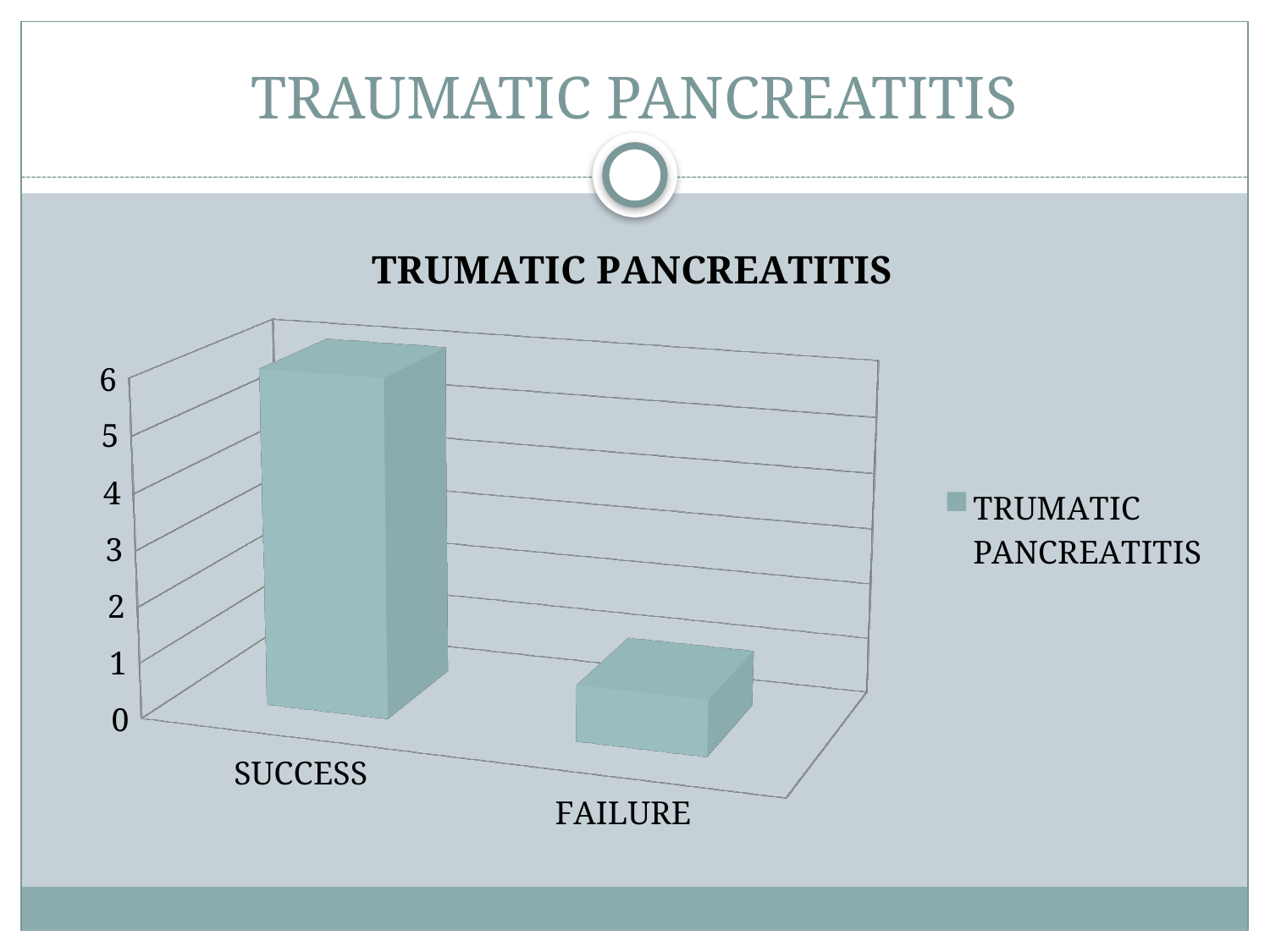
Is the value for FAILURE greater or less than 3? less Is the value for SUCCESS greater or less than 4? greater What is the title of the chart? TRUMATIC PANCREATITIS Which category has the highest bar in the chart? SUCCESS Which category has the lowest bar in the chart? FAILURE What is the name of the series listed in the chart's legend? TRUMATIC PANCREATITIS Do the bar values rise or fall from SUCCESS to FAILURE along the x axis? fall Is the value for SUCCESS greater or less than 2? greater Which is larger, the value for SUCCESS or the value for FAILURE? SUCCESS What kind of chart is shown on the slide? bar chart How many series does the chart's legend list? 1 How many categories are shown on the x axis of the chart? 2